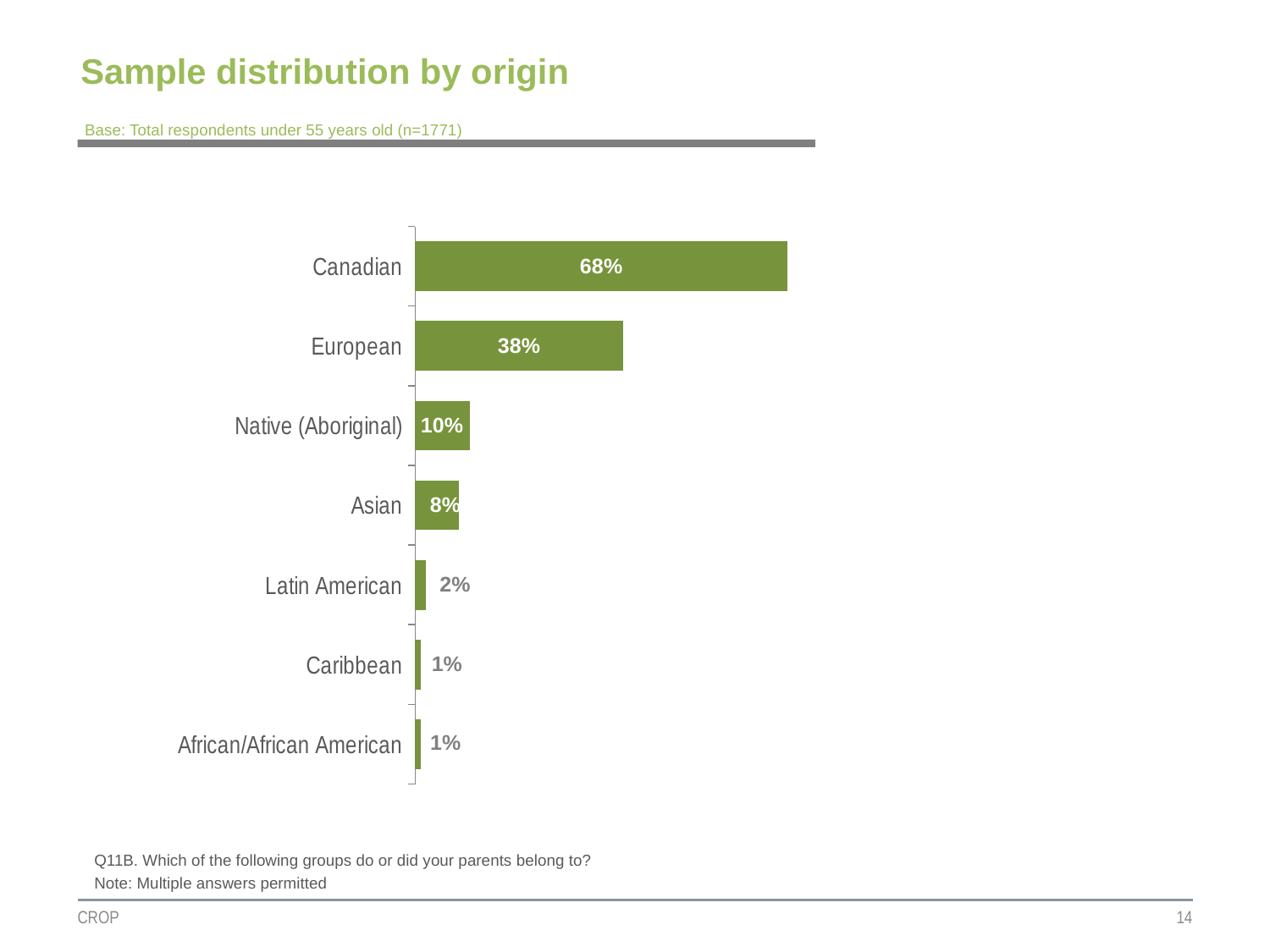
How many categories are shown in the chart? 7 What is the value for Latin American? 2% What is the value for European? 38% What is the difference between the values for Canadian and European? 30% What is the difference between the values for Native (Aboriginal) and Asian? 2% What kind of chart is shown on the slide? Bar chart What is the value for Native (Aboriginal)? 10% What is the value for Asian? 8% Which is larger, the value for European or the value for Asian? European What is the title of the slide? Sample distribution by origin Which category has the highest value? Canadian What is the value for Canadian? 68%